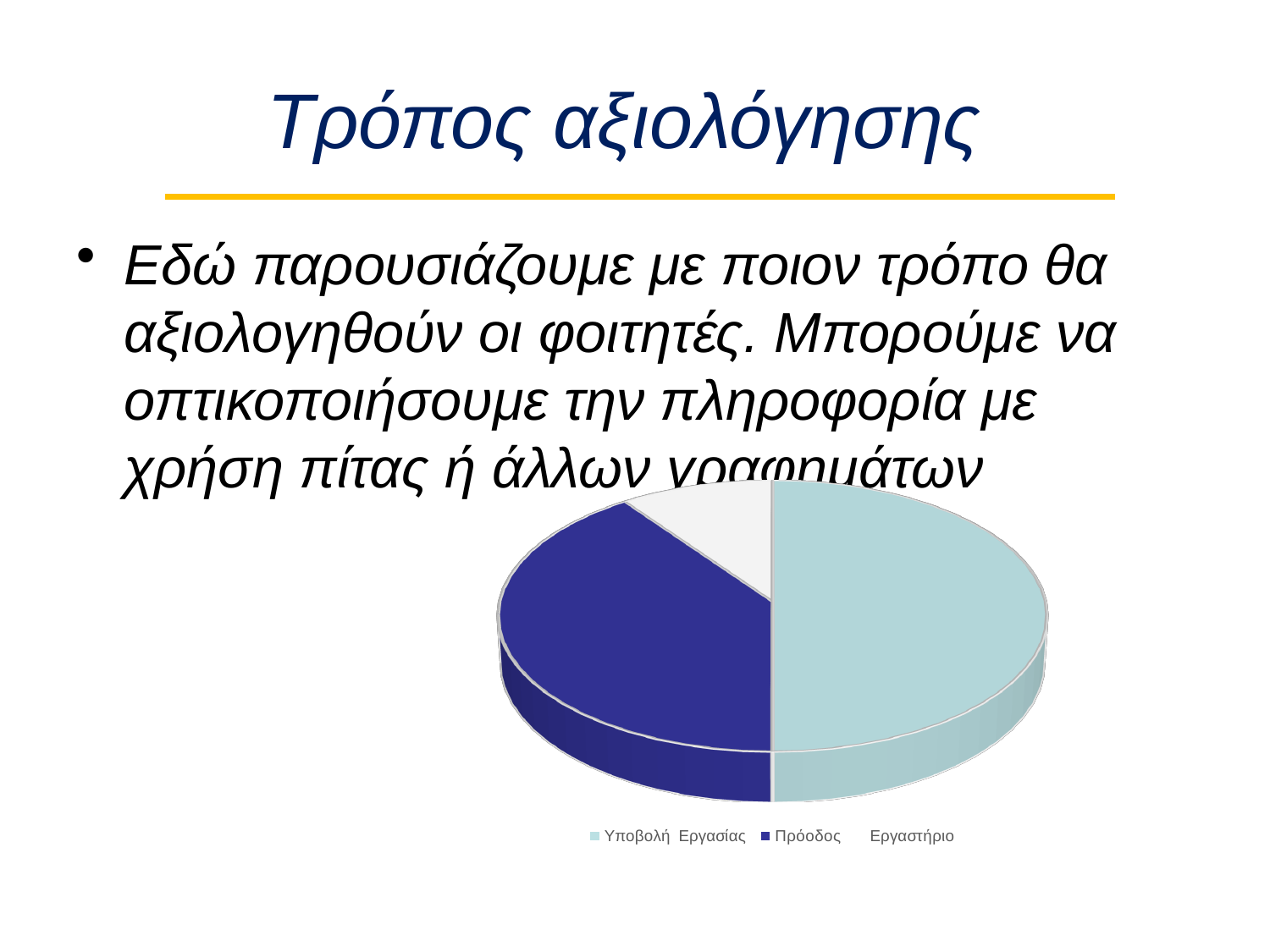
Which category has the smallest slice in the pie chart? Εργαστήριο Which slice is larger in the pie chart, Πρόοδος or Εργαστήριο? Πρόοδος Which legend entry is listed first in the pie chart's legend? Υποβολή Εργασίας What kind of chart is shown on the slide? Pie chart Which slice is larger in the pie chart, Υποβολή Εργασίας or Πρόοδος? Υποβολή Εργασίας How many entries does the legend of the pie chart list? 3 How many slices does the pie chart have? 3 Which category has the largest slice in the pie chart? Υποβολή Εργασίας What colour is the Πρόοδος slice in the pie chart? Dark blue